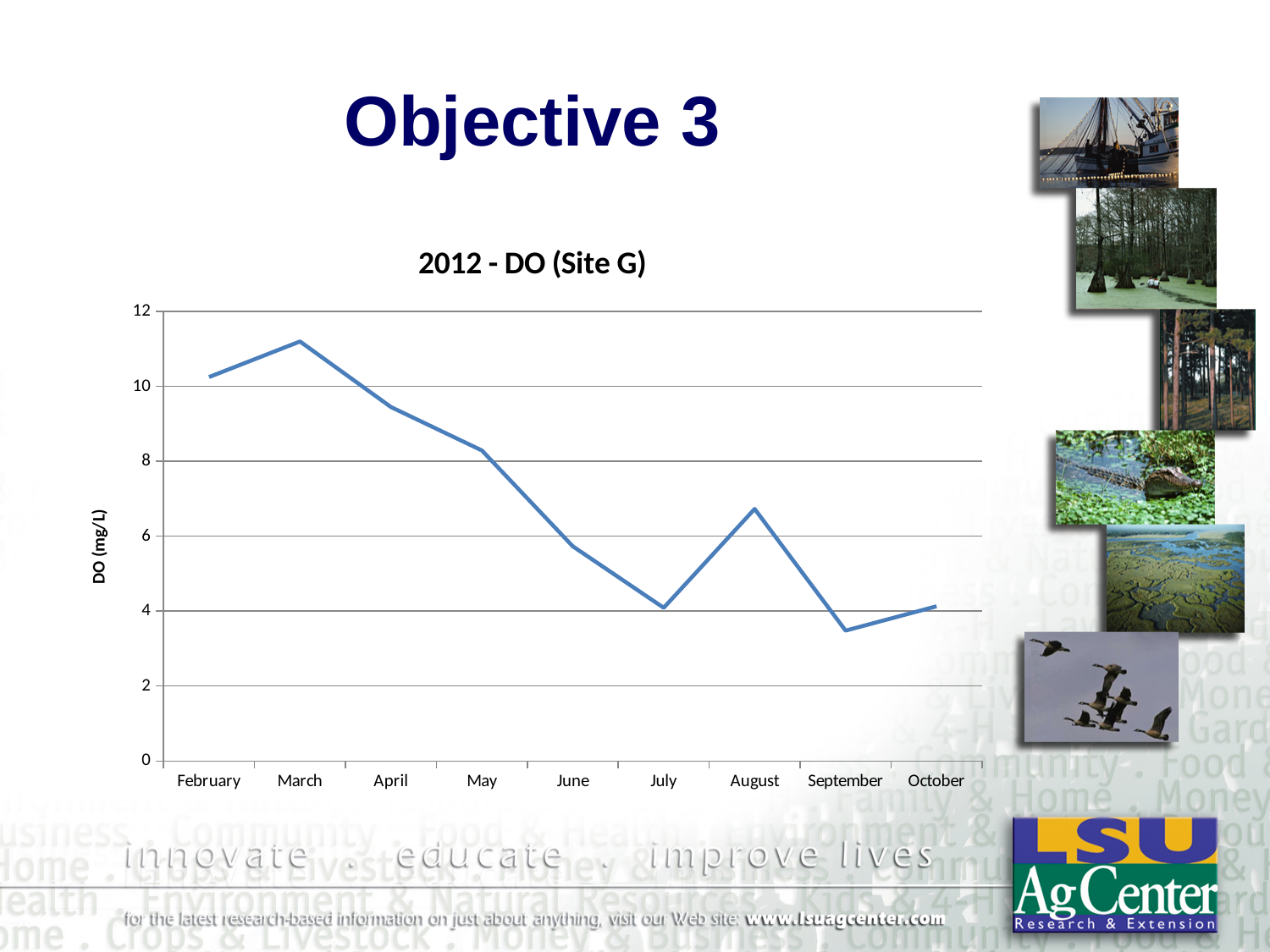
Is the DO value for April greater or less than 10? less Which month has the highest DO value? March Does the DO value rise or fall from March to July? fall What is the title of the chart? 2012 - DO (Site G) What kind of chart is shown on the slide? line chart Which month has the lowest DO value? September Is the DO value for March greater or less than 10? greater How many months are plotted along the x axis? 9 What is the label on the y axis of the chart? DO (mg/L) Is the DO value for August greater or less than 6? greater Which month has a higher DO value, June or August? August